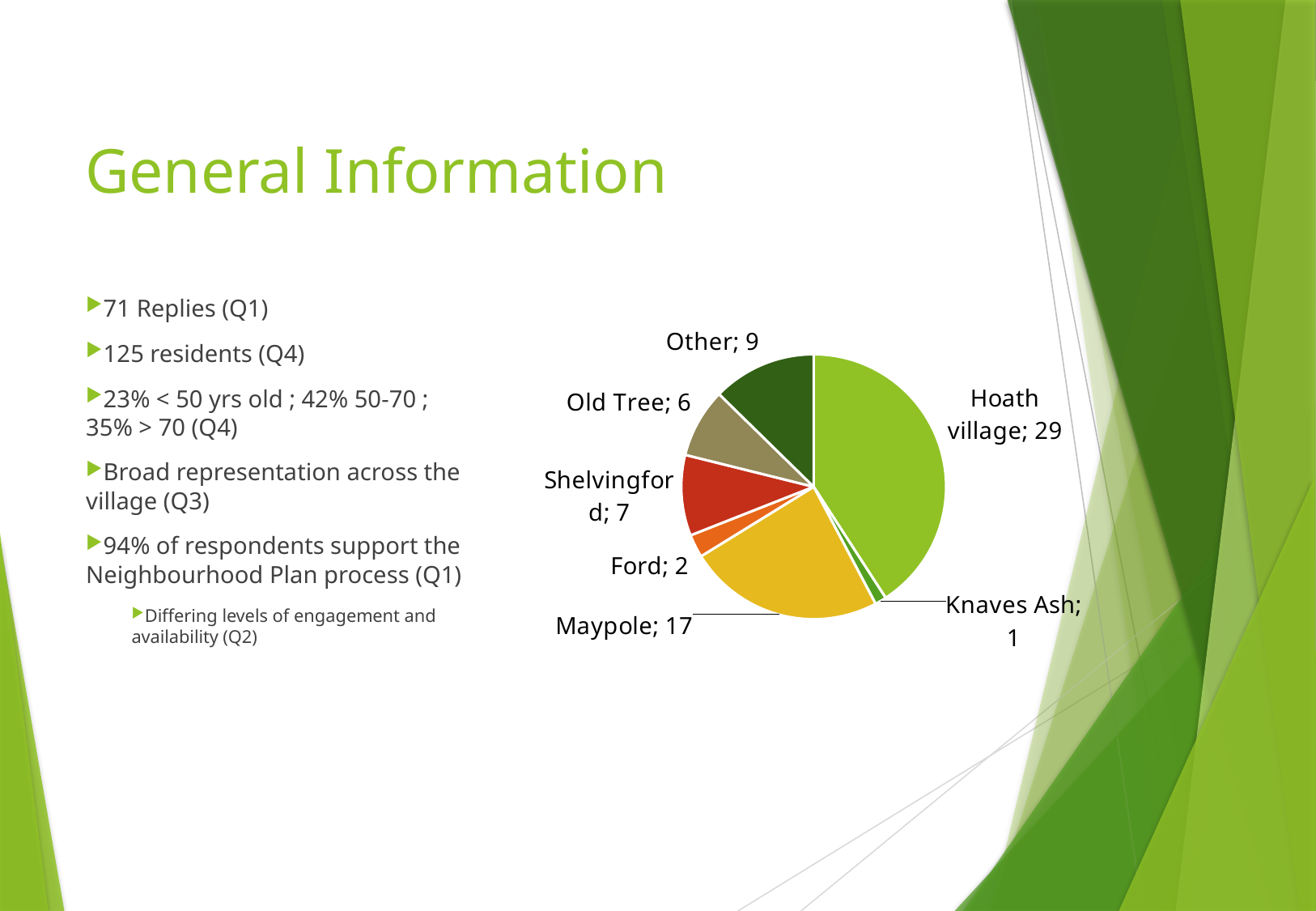
What is the total of all the slices in the pie chart? 71 Which category has the largest slice in the pie chart? Hoath village How many slices does the pie chart have? 7 What is the value for Hoath village in the pie chart? 29 What is the value for Knaves Ash in the pie chart? 1 What kind of chart is shown on the slide? pie chart What is the value for Maypole in the pie chart? 17 Which category has the smallest slice in the pie chart? Knaves Ash What is the difference between the values for Shelvingford and Ford? 5 Which is larger in the pie chart, Old Tree or Other? Other What is the difference between the values for Hoath village and Maypole? 12 What is the value for Shelvingford in the pie chart? 7